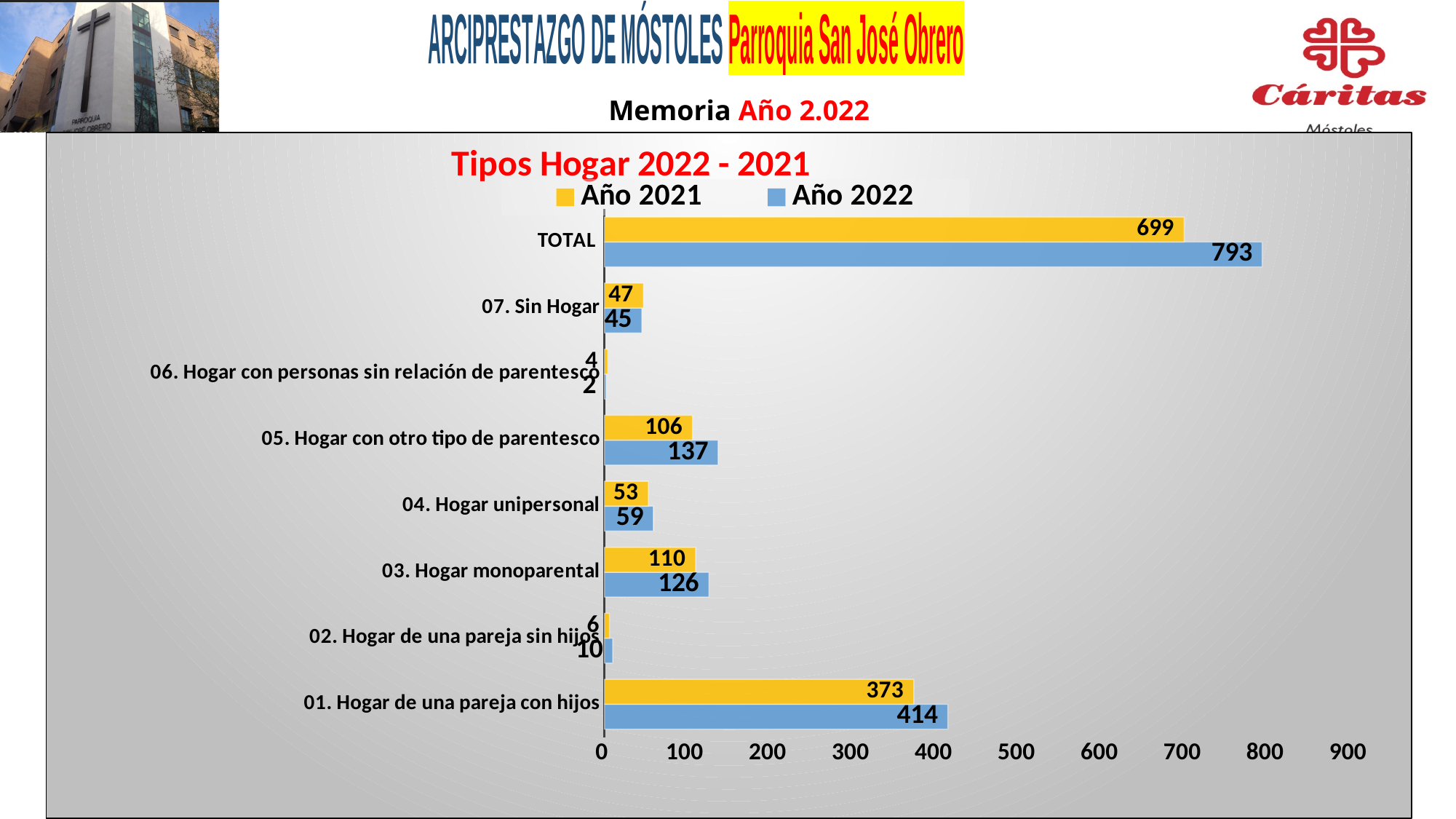
For 07. Sin Hogar, which series has the larger value, Año 2021 or Año 2022? Año 2021 What is the difference between the Año 2022 and Año 2021 values for 03. Hogar monoparental? 16 How many series does the legend list? 2 What type of chart is shown on the slide? Bar chart Is the Año 2022 value for 01. Hogar de una pareja con hijos greater or less than 400? greater Excluding TOTAL, which category has the highest value in the Año 2022 series? 01. Hogar de una pareja con hijos How many categories are shown on the chart, including TOTAL? 8 What is the value for 01. Hogar de una pareja con hijos in the Año 2021 series? 373 What is the difference between the Año 2022 and Año 2021 values for TOTAL? 94 Which category has the lowest value in the Año 2022 series? 06. Hogar con personas sin relación de parentesco What is the value for TOTAL in the Año 2022 series? 793 What is the value for 05. Hogar con otro tipo de parentesco in the Año 2022 series? 137